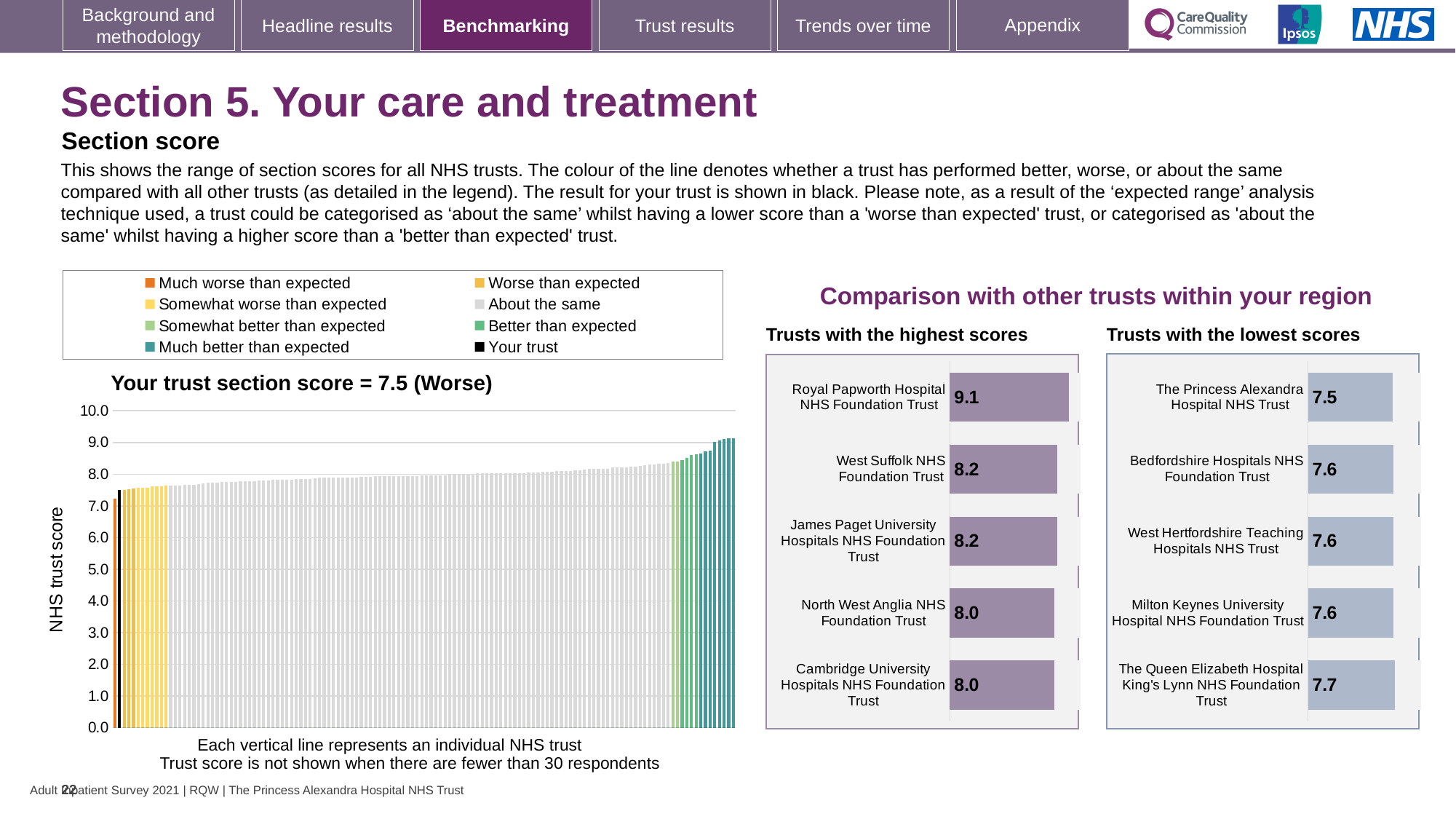
In the 'Trusts with the highest scores' chart, what is the difference between the scores of Royal Papworth Hospital NHS Foundation Trust and Cambridge University Hospitals NHS Foundation Trust? 1.1 In the 'Trusts with the highest scores' chart, which has the larger score: West Suffolk NHS Foundation Trust or North West Anglia NHS Foundation Trust? West Suffolk NHS Foundation Trust In the 'Trusts with the highest scores' chart, what is the score for Royal Papworth Hospital NHS Foundation Trust? 9.1 What is the y-axis label of the 'Your trust section score' chart? NHS trust score In the 'Your trust section score' chart, what is the section score for your trust? 7.5 In the 'Trusts with the lowest scores' chart, which trust has the lowest score? The Princess Alexandra Hospital NHS Trust In the 'Your trust section score' chart, is the value for your trust greater or less than 8.0? less In the 'Trusts with the highest scores' chart, which trust has the highest score? Royal Papworth Hospital NHS Foundation Trust How many trusts are shown in the 'Trusts with the lowest scores' chart? 5 In the 'Trusts with the lowest scores' chart, what is the score for The Queen Elizabeth Hospital King's Lynn NHS Foundation Trust? 7.7 What kind of chart is the 'Your trust section score' chart? bar chart How many entries does the legend above the 'Your trust section score' chart list? 8